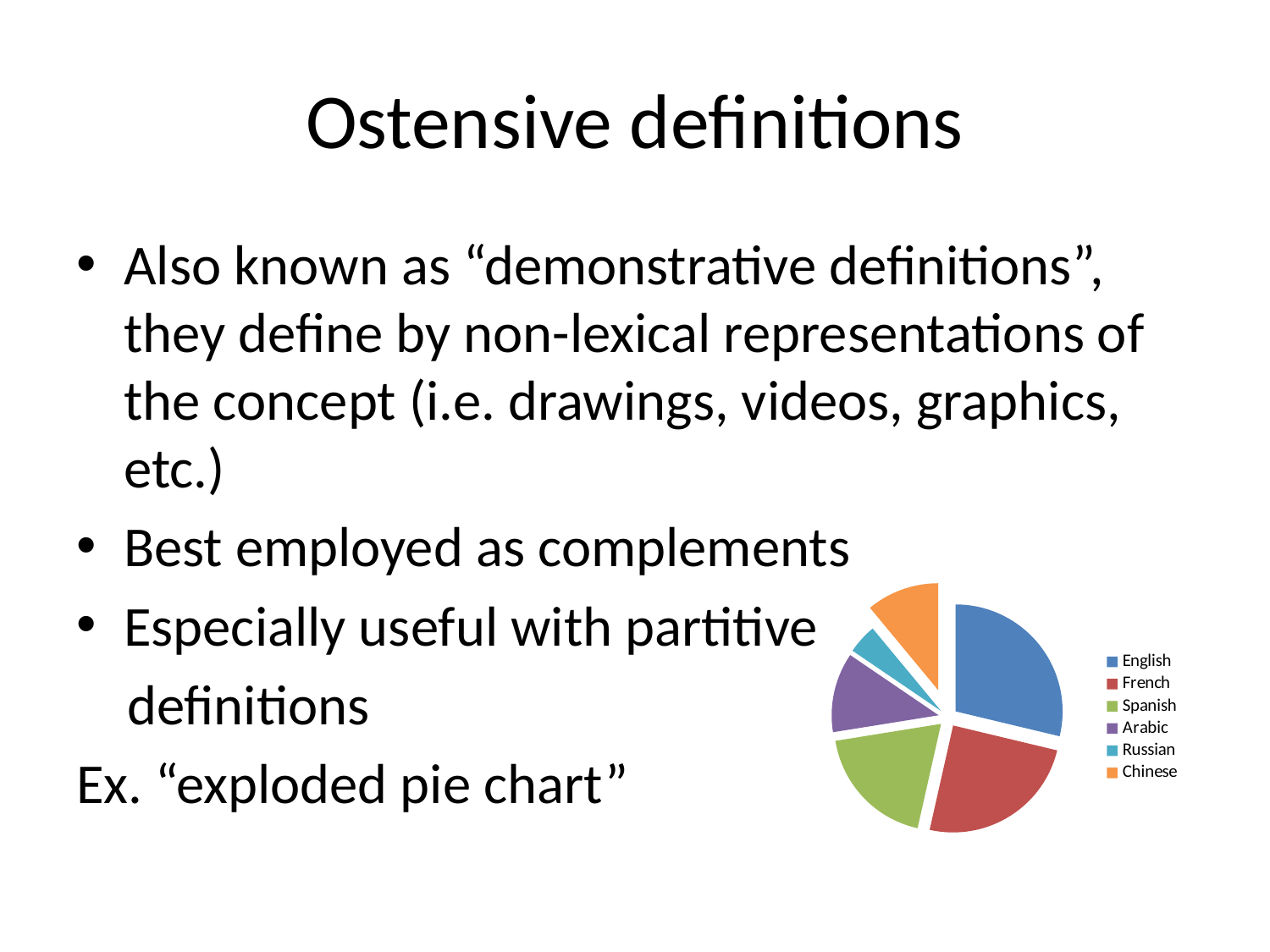
How many categories does the pie chart show? 6 Which category has the smallest slice in the pie chart? Russian How many entries does the legend of the pie chart list? 6 Which category is shown in orange in the pie chart? Chinese Which slice is larger in the pie chart, French or Arabic? French Which slice is larger in the pie chart, Spanish or Russian? Spanish What kind of chart is shown on the slide? pie chart Which category has the largest slice in the pie chart? English What colour is the English slice in the pie chart? blue Which slice is larger in the pie chart, English or Chinese? English